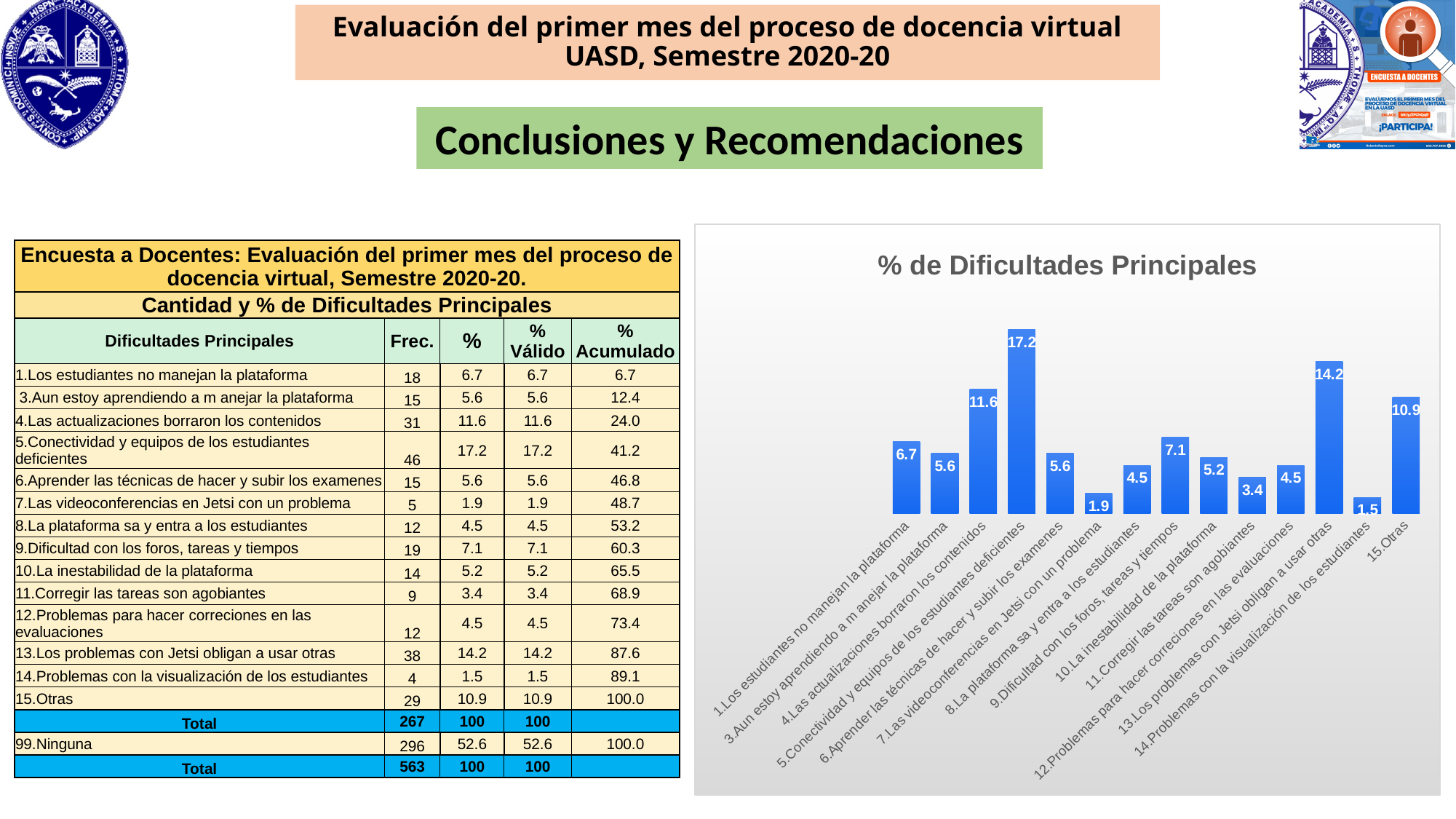
What is the difference between the values for "5.Conectividad y equipos de los estudiantes deficientes" and "13.Los problemas con Jetsi obligan a usar otras"? 3.0 What type of chart is shown on the slide? bar chart What is the value for "13.Los problemas con Jetsi obligan a usar otras"? 14.2 What is the value for "15.Otras"? 10.9 How many bars are plotted in the chart? 14 Which category has the highest value? 5.Conectividad y equipos de los estudiantes deficientes What is the difference between the values for "1.Los estudiantes no manejan la plataforma" and "11.Corregir las tareas son agobiantes"? 3.3 What is the value for "5.Conectividad y equipos de los estudiantes deficientes"? 17.2 Which is larger, the value for "4.Las actualizaciones borraron los contenidos" or the value for "15.Otras"? 4.Las actualizaciones borraron los contenidos What is the value for "7.Las videoconferencias en Jetsi con un problema"? 1.9 What is the title of the chart? % de Dificultades Principales Which category has the lowest value? 14.Problemas con la visualización de los estudiantes